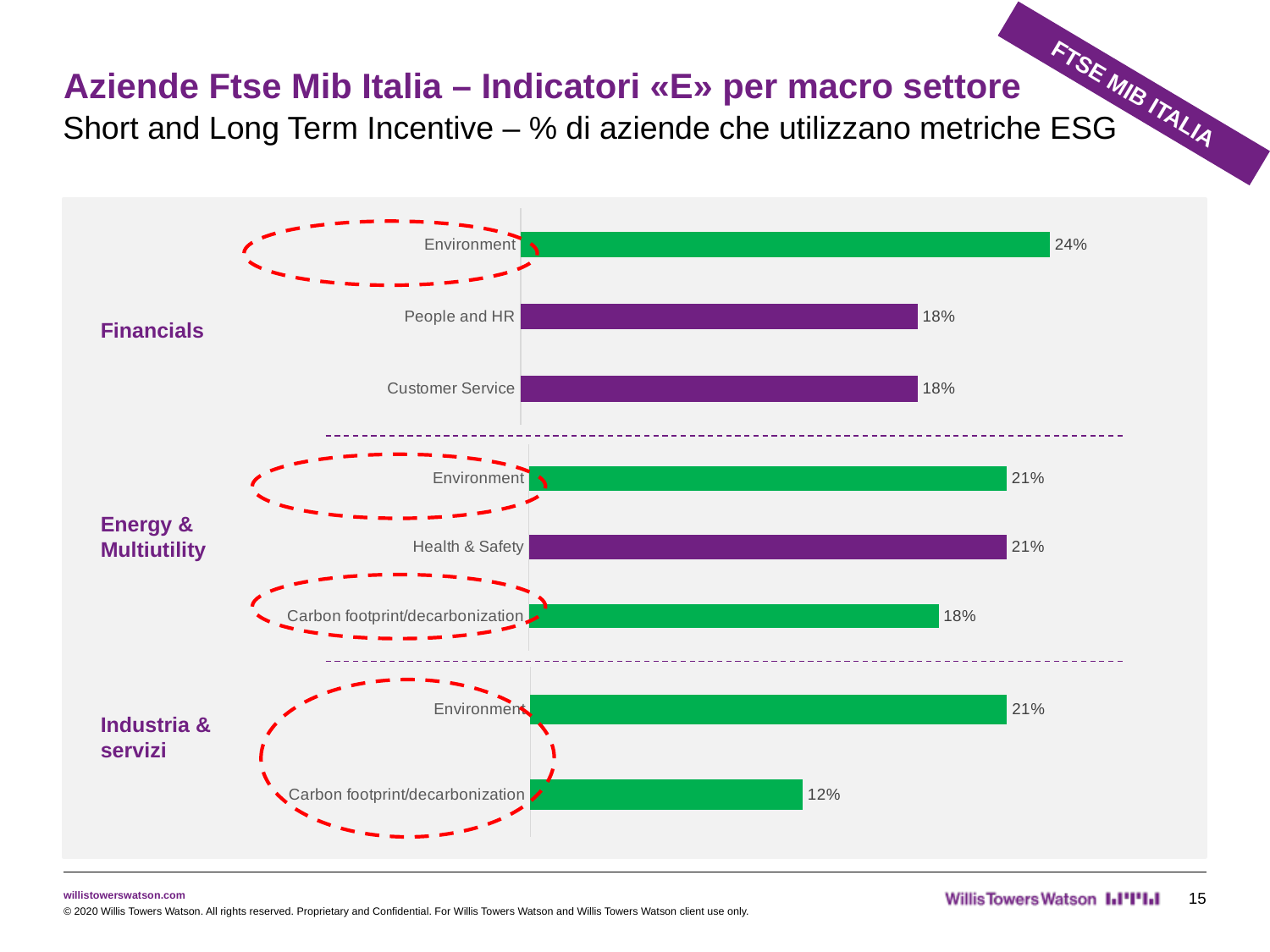
In the Energy & Multiutility section, what is the value for Carbon footprint/decarbonization? 18% What colour are the Environment bars on the slide? Green How many bars are shown in the Energy & Multiutility section? 3 What kind of chart is shown on the slide? Bar chart In the Financials section, what is the difference between Environment and Customer Service? 6% In the Industria & servizi section, what is the value for Carbon footprint/decarbonization? 12% In the Financials section, what is the value for People and HR? 18% Which is larger: Environment in the Financials section or Environment in the Energy & Multiutility section? Environment in the Financials section In the Energy & Multiutility section, which category has the lowest value? Carbon footprint/decarbonization In the Industria & servizi section, what is the difference between Environment and Carbon footprint/decarbonization? 9% In the Financials section, what is the value for Environment? 24% In the Financials section, which category has the highest value? Environment